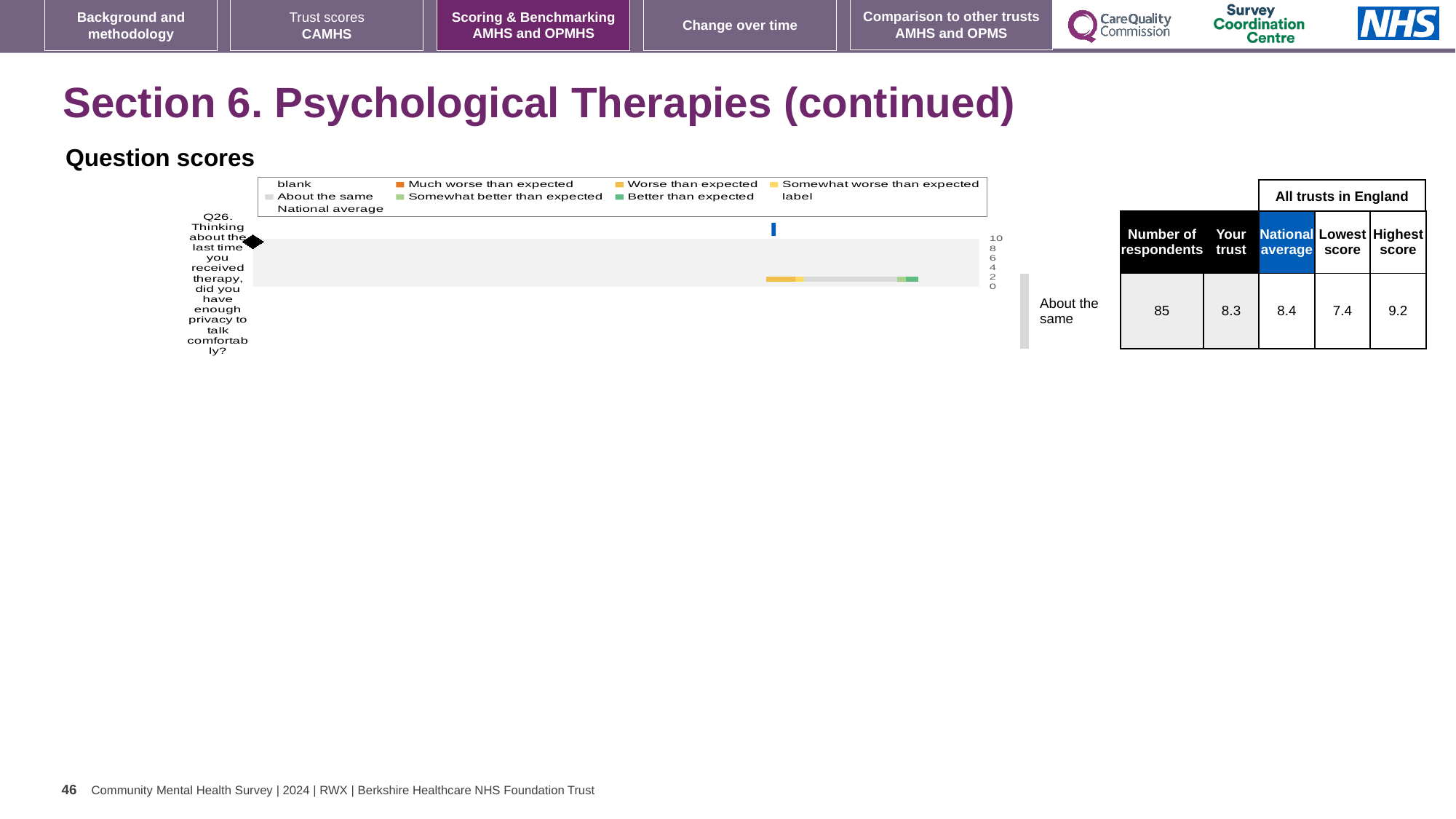
What is the national average score for Q26 shown alongside the chart? 8.4 What benchmark category is the trust's Q26 score placed in? About the same Is the trust's score for Q26 greater or less than 6 on the chart axis? greater Which question number is plotted in the Question scores chart? Q26 How many survey questions are plotted in the Question scores chart? 1 What kind of chart is shown under 'Question scores'? bar chart What is the difference between the highest and lowest trust scores for Q26? 1.8 How many respondents answered Q26? 85 What is the highest score among all trusts in England for Q26? 9.2 What is the lowest score among all trusts in England for Q26? 7.4 For Q26, which is larger: the trust's score or the national average? National average What is the 'Your trust' score for Q26 shown alongside the chart? 8.3